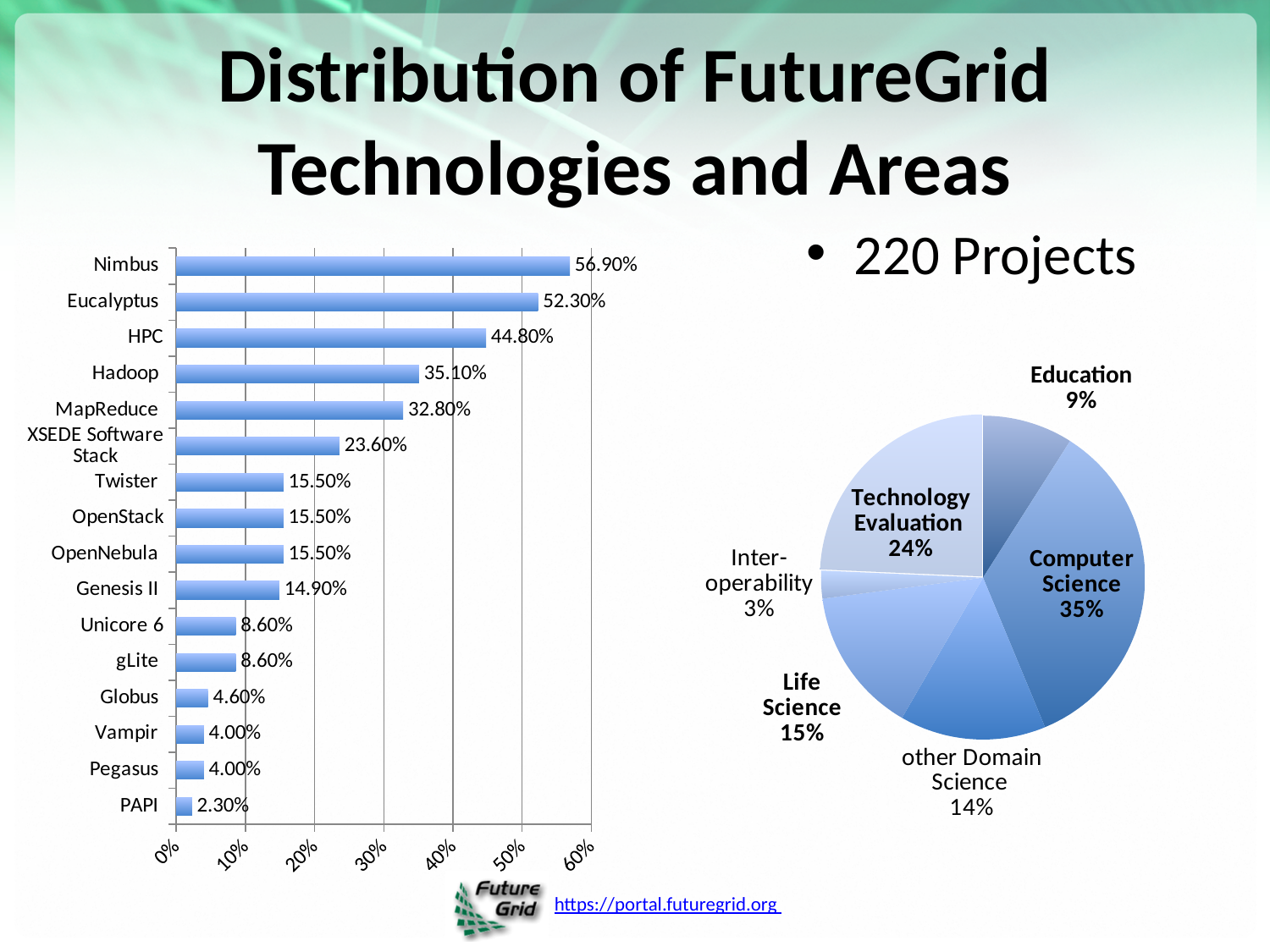
How many technologies are listed in the bar chart on the left? 16 In the bar chart on the left, which technology has the lowest value? PAPI In the bar chart on the left, what is the value for XSEDE Software Stack? 23.60% In the pie chart on the right, what is the difference between the shares of Technology Evaluation and Life Science? 9% In the bar chart on the left, what is the value for Nimbus? 56.90% In the bar chart on the left, which has a larger value, Hadoop or MapReduce? Hadoop In the pie chart on the right, what share does Computer Science have? 35% What kind of chart is the chart on the left of the slide? Bar chart In the bar chart on the left, what is the difference between the values for Eucalyptus and HPC? 7.50% How many slices does the pie chart on the right have? 6 In the pie chart on the right, which area has the smallest share? Inter-operability In the bar chart on the left, which technology has the highest value? Nimbus